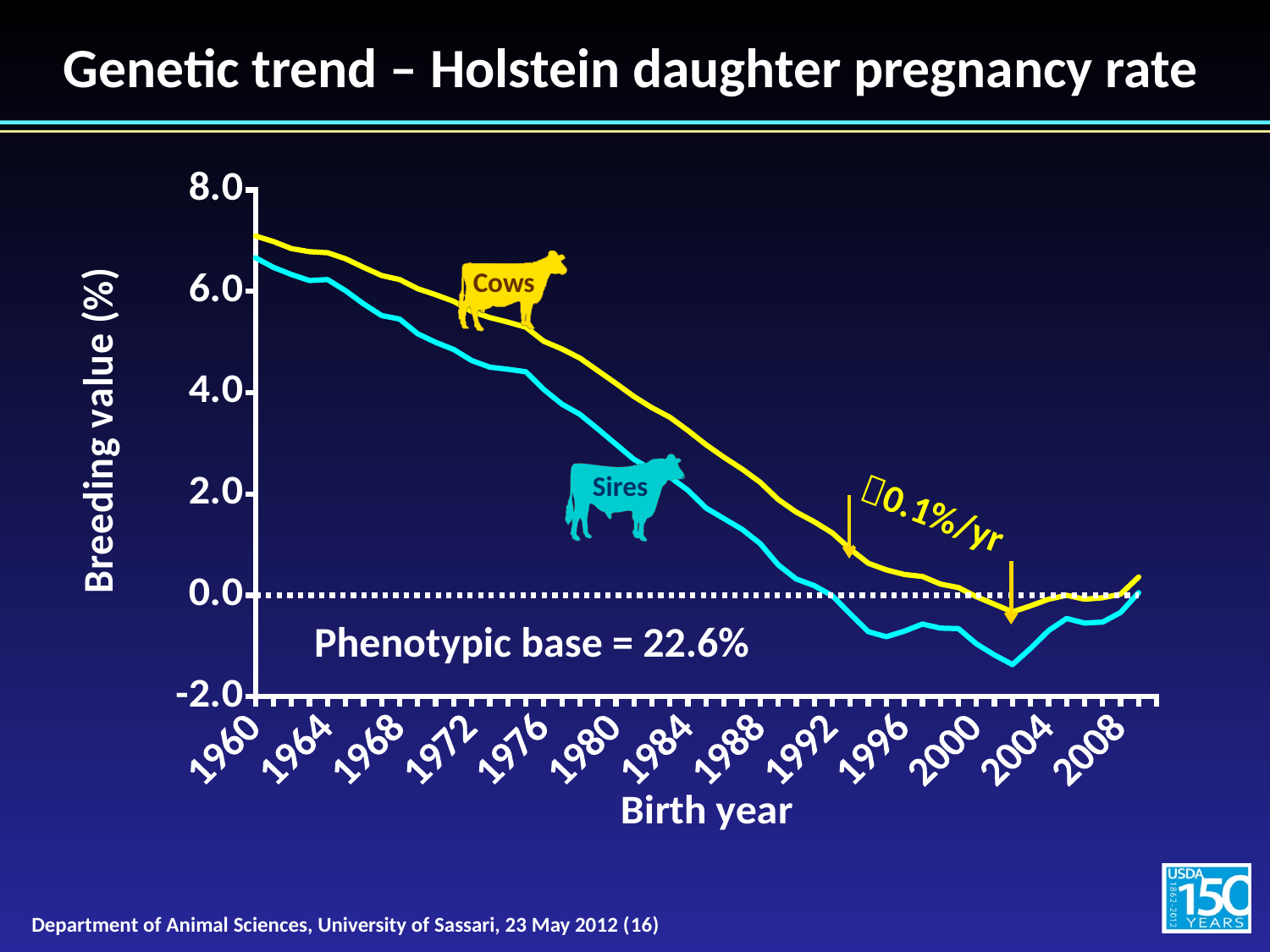
How many series are plotted on the chart? 2 Is the breeding value for Sires in 1980 greater or less than 4.0? less In 1976, which series has the higher breeding value, Cows or Sires? Cows What are the names of the two series plotted on the chart? Cows and Sires Is the breeding value for Cows in 1960 greater or less than 6.0? greater What phenotypic base is stated on the chart? 22.6% Is the breeding value for Sires in 2004 greater or less than 0.0? less What kind of chart is shown on the slide? Line chart Do the breeding values for Cows generally rise or fall from 1960 to 2004? Fall What is the label of the y axis? Breeding value (%)